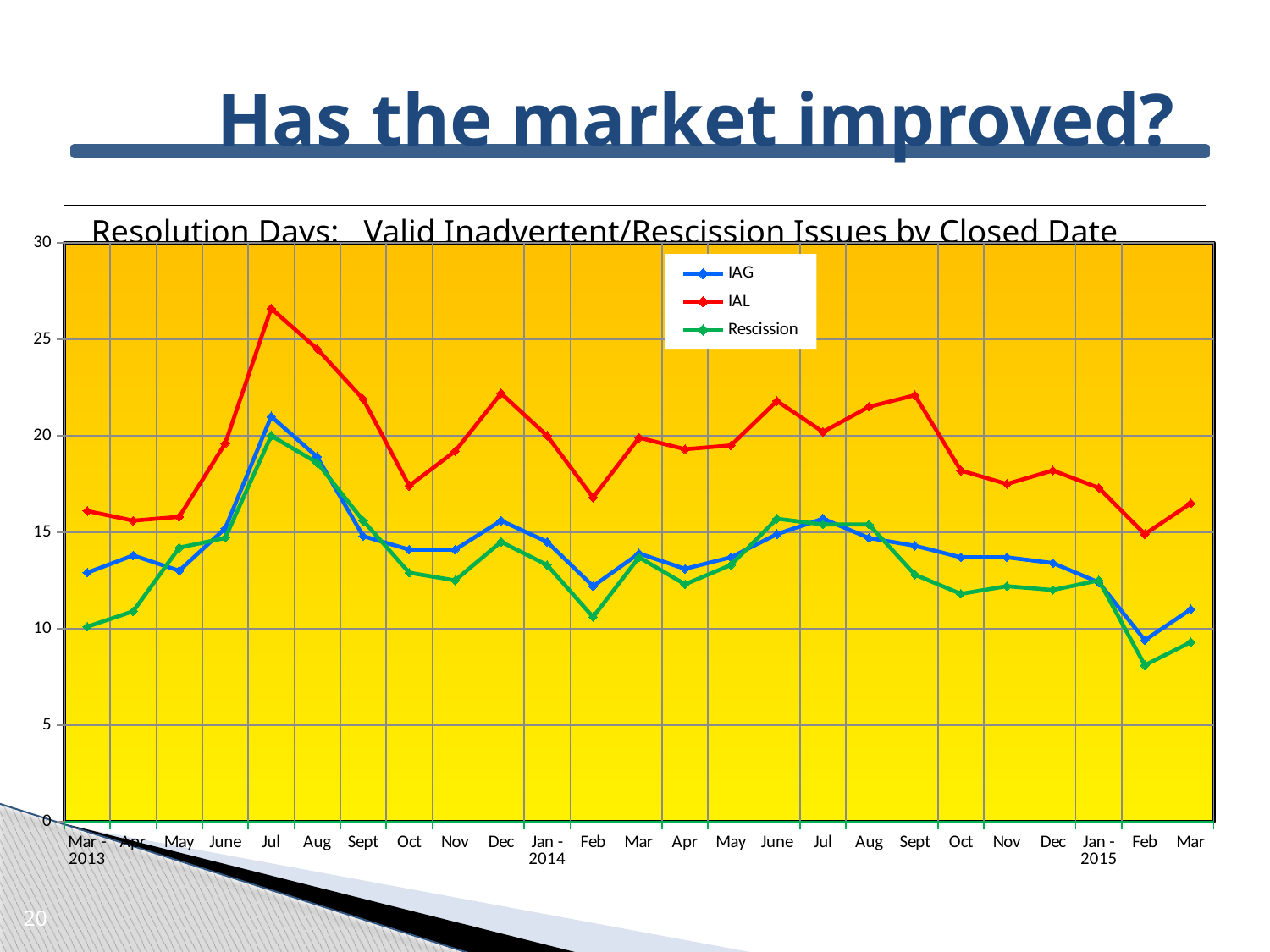
Which series has the larger value in Jul 2013, IAL or Rescission? IAL What is the title of the chart? Resolution Days: Valid Inadvertent/Rescission Issues by Closed Date In which month does the Rescission series reach its lowest value? Feb 2015 What kind of chart is shown on the slide? line chart How many series does the legend list? 3 Is the IAL value for Jul 2013 greater or less than 25? greater How many months are plotted along the x axis? 25 Is the Rescission value for Feb 2015 greater or less than 10? less Which series is drawn in red? IAL In which month does the IAG series reach its lowest value? Feb 2015 Is the IAL value for Oct 2013 greater or less than 20? less In which month does the IAL series reach its highest value? Jul 2013